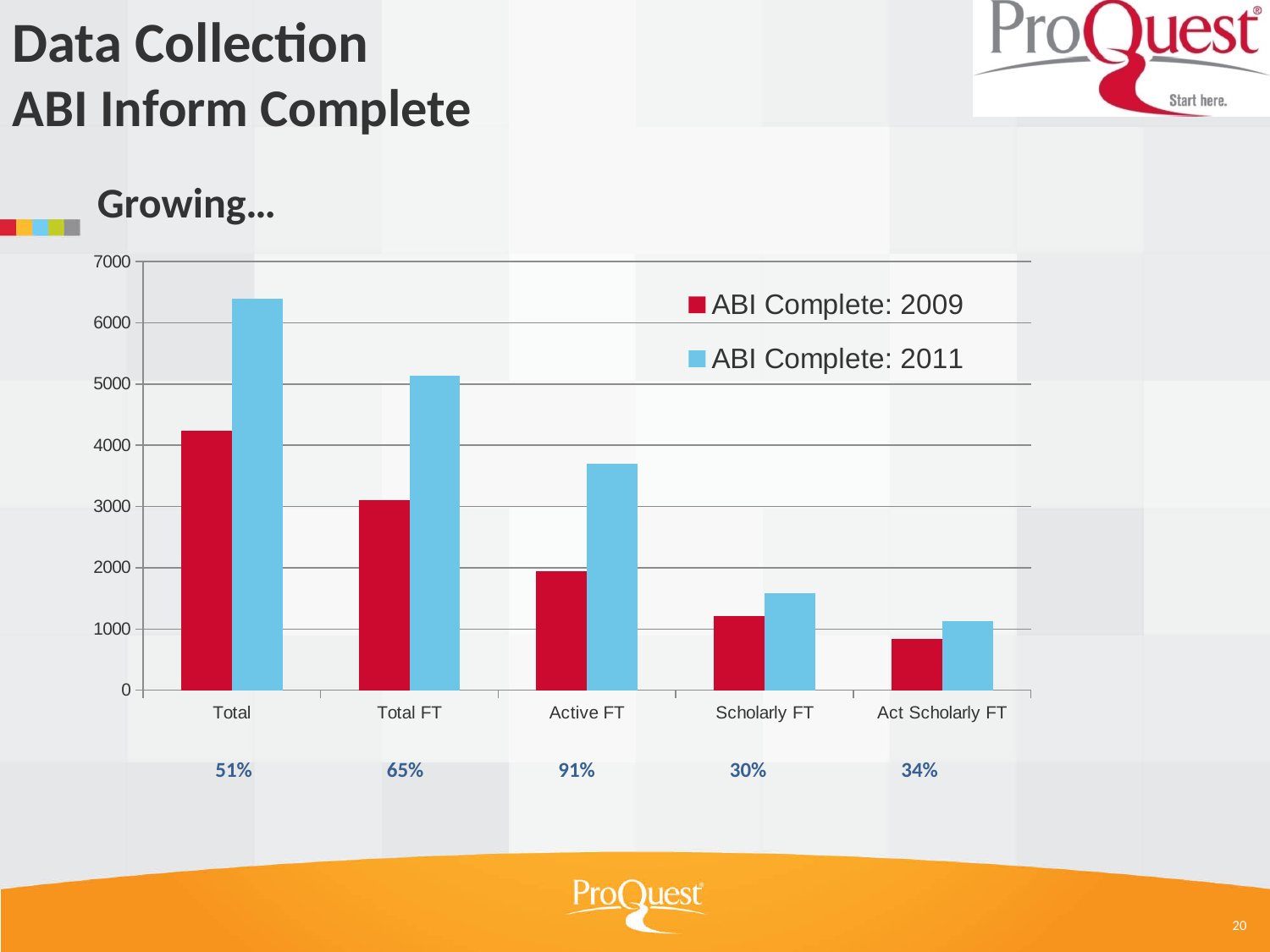
Which category has the tallest bar for ABI Complete: 2011? Total Is the value for Active FT in ABI Complete: 2011 greater or less than 4000? less How many series does the legend list? 2 For Total FT, which series has the larger value, ABI Complete: 2009 or ABI Complete: 2011? ABI Complete: 2011 What kind of chart is shown on the slide? bar chart Is the value for Total in ABI Complete: 2011 greater or less than 6000? greater Do the ABI Complete: 2011 values rise or fall moving from Total to Act Scholarly FT along the x axis? fall How many categories are shown on the x axis? 5 Is the value for Total in ABI Complete: 2009 greater or less than 4000? greater Which category has the shortest bar for ABI Complete: 2009? Act Scholarly FT What percentage is printed below the Active FT category? 91%